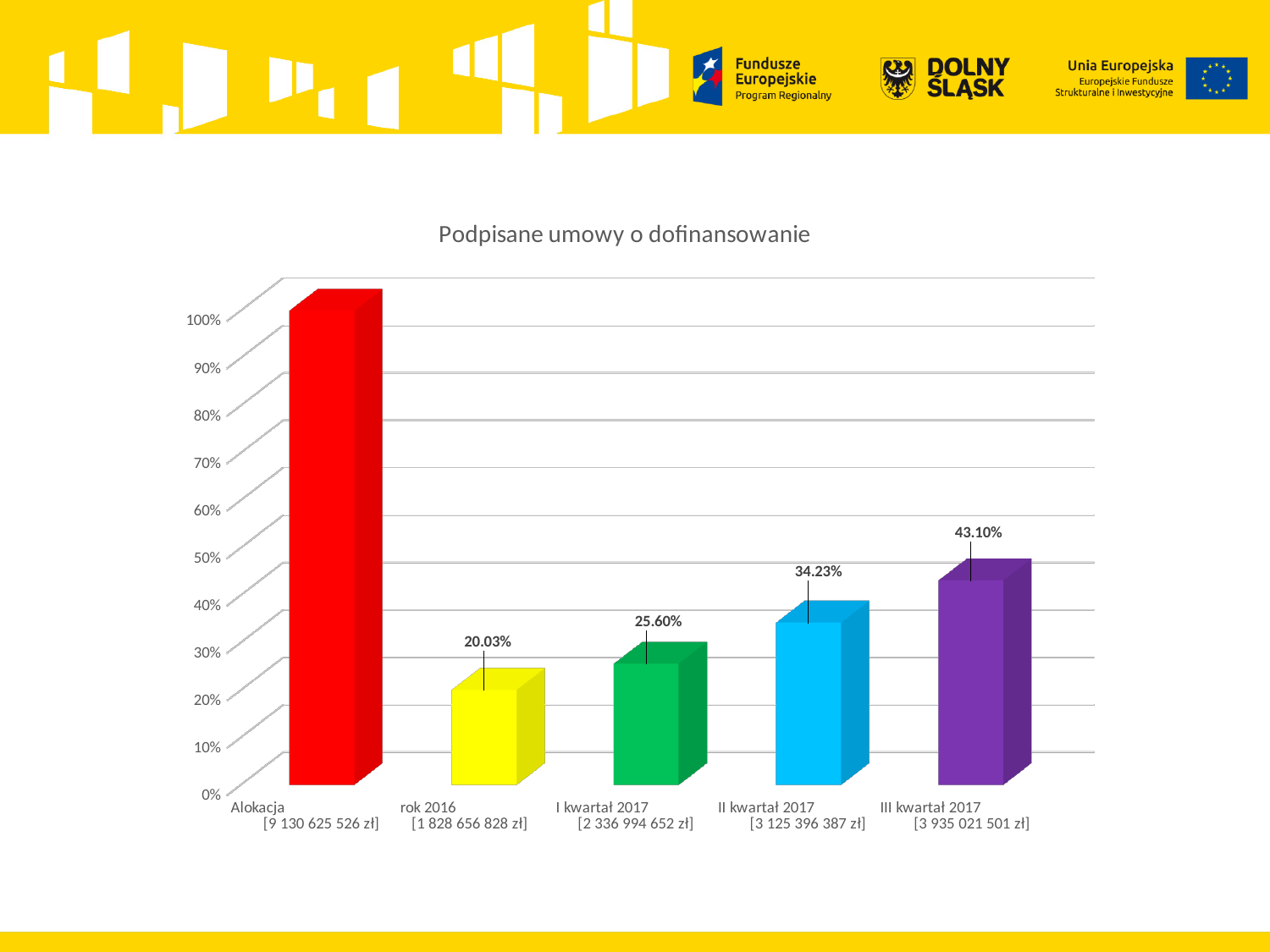
What is the value for II kwartał 2017? 34.23% What is the value for I kwartał 2017? 25.60% Is the value for Alokacja greater or less than 90%? greater What is the value for rok 2016? 20.03% What is the title of the chart? Podpisane umowy o dofinansowanie Which category has the highest value? Alokacja Which is larger, the value for II kwartał 2017 or the value for I kwartał 2017? II kwartał 2017 Which category has the lowest value? rok 2016 What is the difference between the values for III kwartał 2017 and rok 2016? 23.07% How many categories are shown on the x axis? 5 What type of chart is shown on the slide? bar chart What is the value for III kwartał 2017? 43.10%